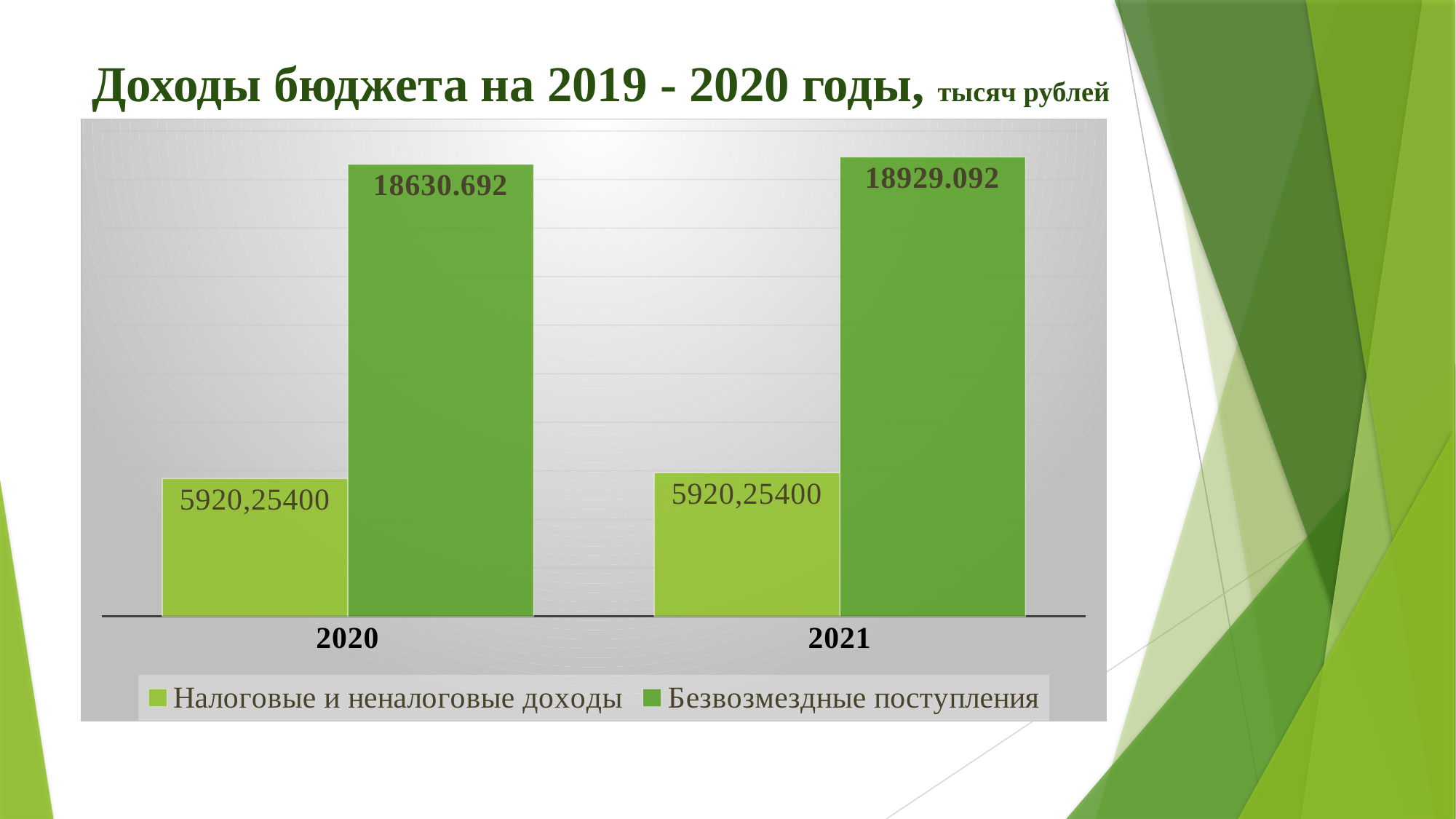
Which is larger in 2021: Налоговые и неналоговые доходы or Безвозмездные поступления? Безвозмездные поступления Does Безвозмездные поступления rise or fall from 2020 to 2021? Rise What is the value of Безвозмездные поступления for 2021? 18929.092 What is the value of Налоговые и неналоговые доходы for 2020? 5920,25400 What kind of chart is shown on the slide? Bar chart What is the value of Безвозмездные поступления for 2020? 18630.692 Which series has the lowest value in 2020? Налоговые и неналоговые доходы How many series does the legend list? 2 What is the difference between Безвозмездные поступления in 2021 and in 2020? 298.400 How many years are shown on the x axis? 2 In which year is Безвозмездные поступления highest? 2021 What is the value of Налоговые и неналоговые доходы for 2021? 5920,25400